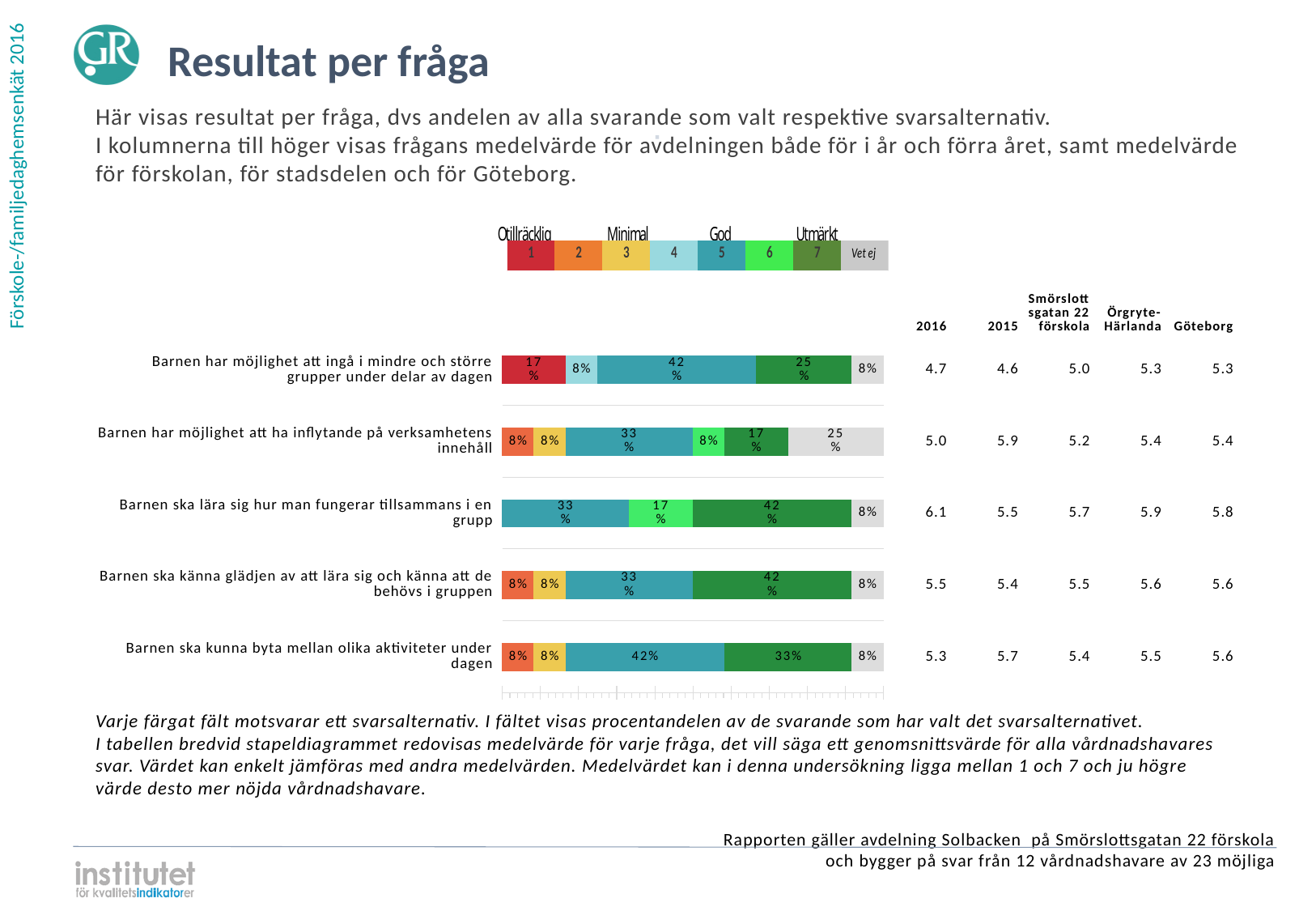
What kind of chart is used to show the results per question? Stacked bar chart How many response options does the legend above the chart list? 8 What is the difference between the option 5 share and the option 7 share for 'Barnen ska känna glädjen av att lära sig och känna att de behövs i gruppen'? 9 percentage points How many questions (bars) are shown in the chart? 5 What is the 2016 mean value for 'Barnen ska lära sig hur man fungerar tillsammans i en grupp'? 6.1 What percentage of respondents chose option 1 (Otillräcklig) for 'Barnen har möjlighet att ingå i mindre och större grupper under delar av dagen'? 17% What percentage chose 'Vet ej' for 'Barnen har möjlighet att ha inflytande på verksamhetens innehåll'? 25% Which response option has the largest share for 'Barnen ska kunna byta mellan olika aktiviteter under dagen'? 5 (42%) For 'Barnen har möjlighet att ingå i mindre och större grupper under delar av dagen', which is larger: the share for option 5 or the share for option 7? Option 5 (42%) What label does the legend give to response option 7? Utmärkt What percentage chose option 7 (Utmärkt) for 'Barnen ska lära sig hur man fungerar tillsammans i en grupp'? 42% What is the total of the printed percentages for 'Barnen ska lära sig hur man fungerar tillsammans i en grupp'? 100%